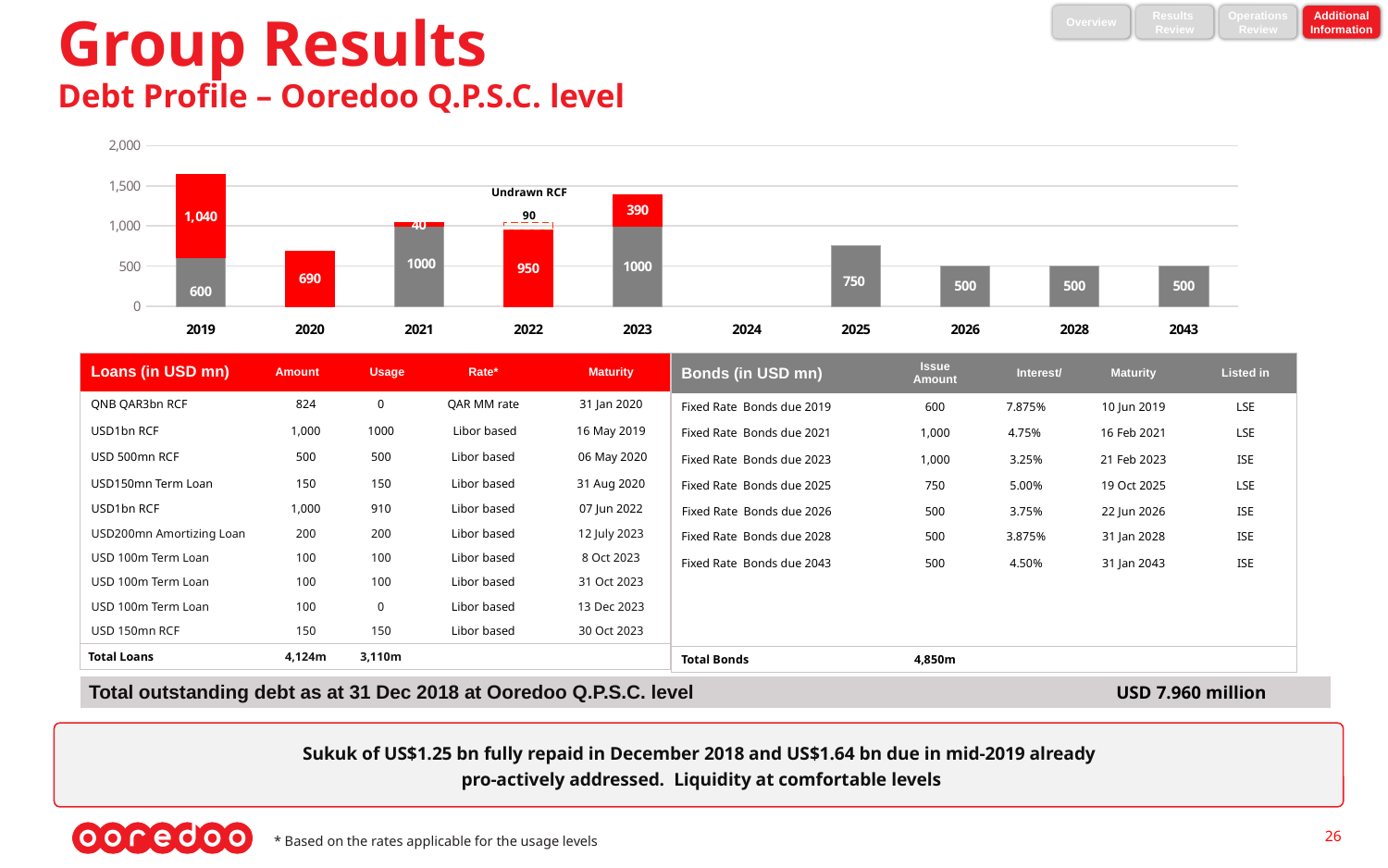
What is the value of the red segment for 2019? 1,040 What is the value of the grey segment for 2019? 600 What is the total of the stacked bar for 2023? 1,390 What kind of chart is shown on the slide? Stacked bar chart What is the value labelled 'Undrawn RCF' above the 2022 bar? 90 What is the total of the stacked bar for 2019? 1,640 Which year has the tallest stacked bar? 2019 What value is shown for 2020? 690 What is the value of the red segment for 2023? 390 What is the difference between the grey segment for 2025 and the grey segment for 2026? 250 How many years are shown on the x axis of the chart? 10 What value is shown for 2025? 750